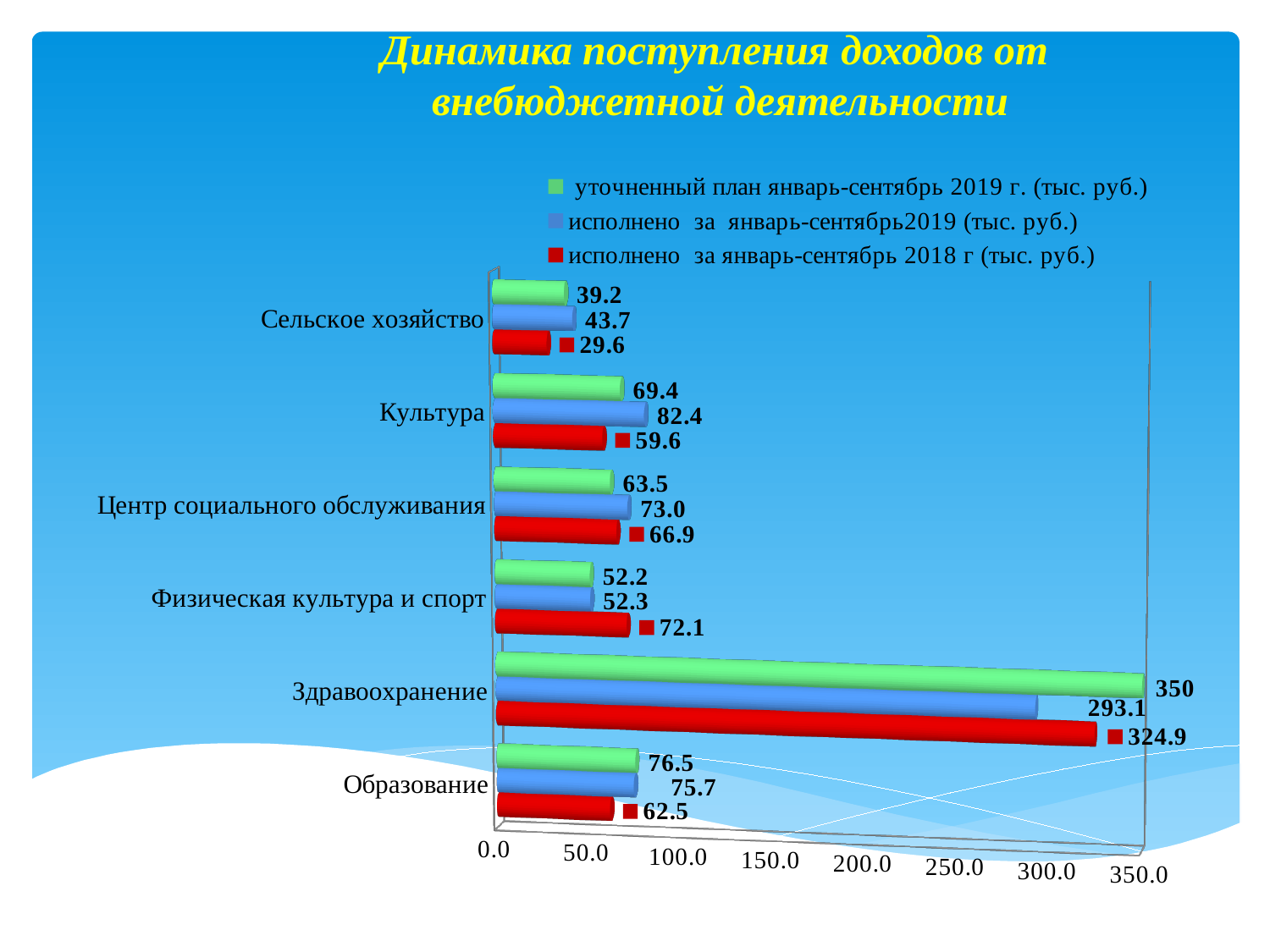
Which category has the lowest value for 'исполнено за январь-сентябрь 2018 г'? Сельское хозяйство For Образование, which is larger: 'уточненный план январь-сентябрь 2019 г.' or 'исполнено за январь-сентябрь 2018 г'? уточненный план январь-сентябрь 2019 г. Is the value of 'исполнено за январь-сентябрь 2019' for Здравоохранение greater or less than 250.0? greater How many series does the legend list? 3 How many categories are shown on the chart? 6 What type of chart is shown on the slide? Bar chart What is the difference between 'исполнено за январь-сентябрь 2018 г' and 'исполнено за январь-сентябрь 2019' for Здравоохранение? 31.8 Which category has the highest value for 'исполнено за январь-сентябрь 2019'? Здравоохранение What is the value of 'уточненный план январь-сентябрь 2019 г.' for Здравоохранение? 350 What is the value of 'исполнено за январь-сентябрь 2019' for Культура? 82.4 What is the value of 'исполнено за январь-сентябрь 2018 г' for Физическая культура и спорт? 72.1 What is the title of the chart? Динамика поступления доходов от внебюджетной деятельности